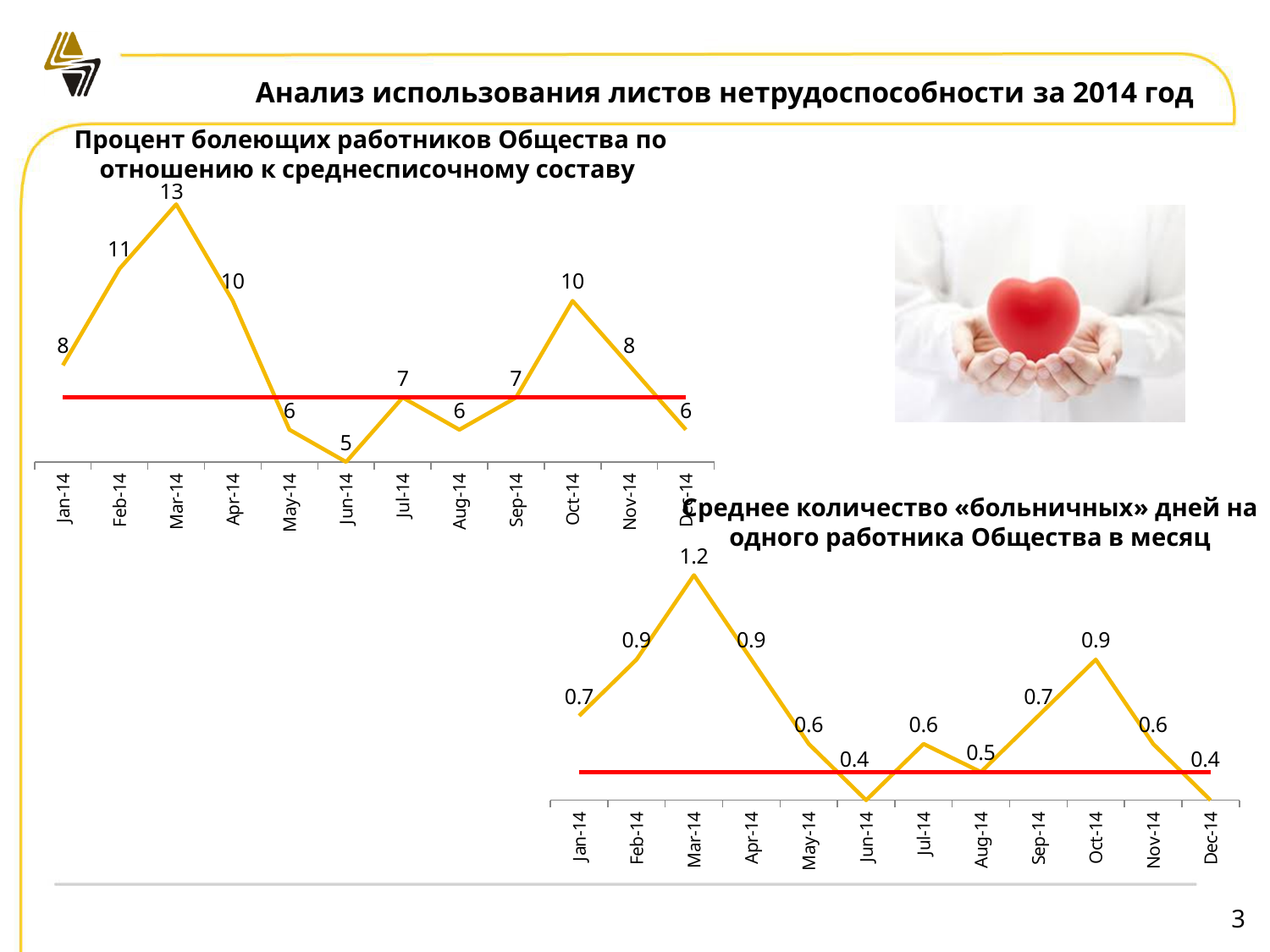
In the chart 'Процент болеющих работников Общества по отношению к среднесписочному составу', which month has the highest value? Mar-14 What kind of chart is 'Среднее количество «больничных» дней на одного работника Общества в месяц'? Line chart In the chart 'Среднее количество «больничных» дней на одного работника Общества в месяц', which is larger, the value for Sep-14 or the value for Nov-14? Sep-14 In the chart 'Среднее количество «больничных» дней на одного работника Общества в месяц', what is the value for Aug-14? 0.5 In the chart 'Среднее количество «больничных» дней на одного работника Общества в месяц', do the values rise or fall from Mar-14 to Jun-14? Fall In the chart 'Процент болеющих работников Общества по отношению к среднесписочному составу', what is the difference between the values for Mar-14 and Jun-14? 8 In the chart 'Процент болеющих работников Общества по отношению к среднесписочному составу', what is the value for Oct-14? 10 In the chart 'Процент болеющих работников Общества по отношению к среднесписочному составу', which month has the lowest value? Jun-14 In the chart 'Среднее количество «больничных» дней на одного работника Общества в месяц', what is the difference between the values for Mar-14 and Dec-14? 0.8 In the chart 'Среднее количество «больничных» дней на одного работника Общества в месяц', what is the value for Mar-14? 1.2 In the chart 'Процент болеющих работников Общества по отношению к среднесписочному составу', what is the value for Mar-14? 13 In the chart 'Процент болеющих работников Общества по отношению к среднесписочному составу', how many months are plotted on the x axis? 12